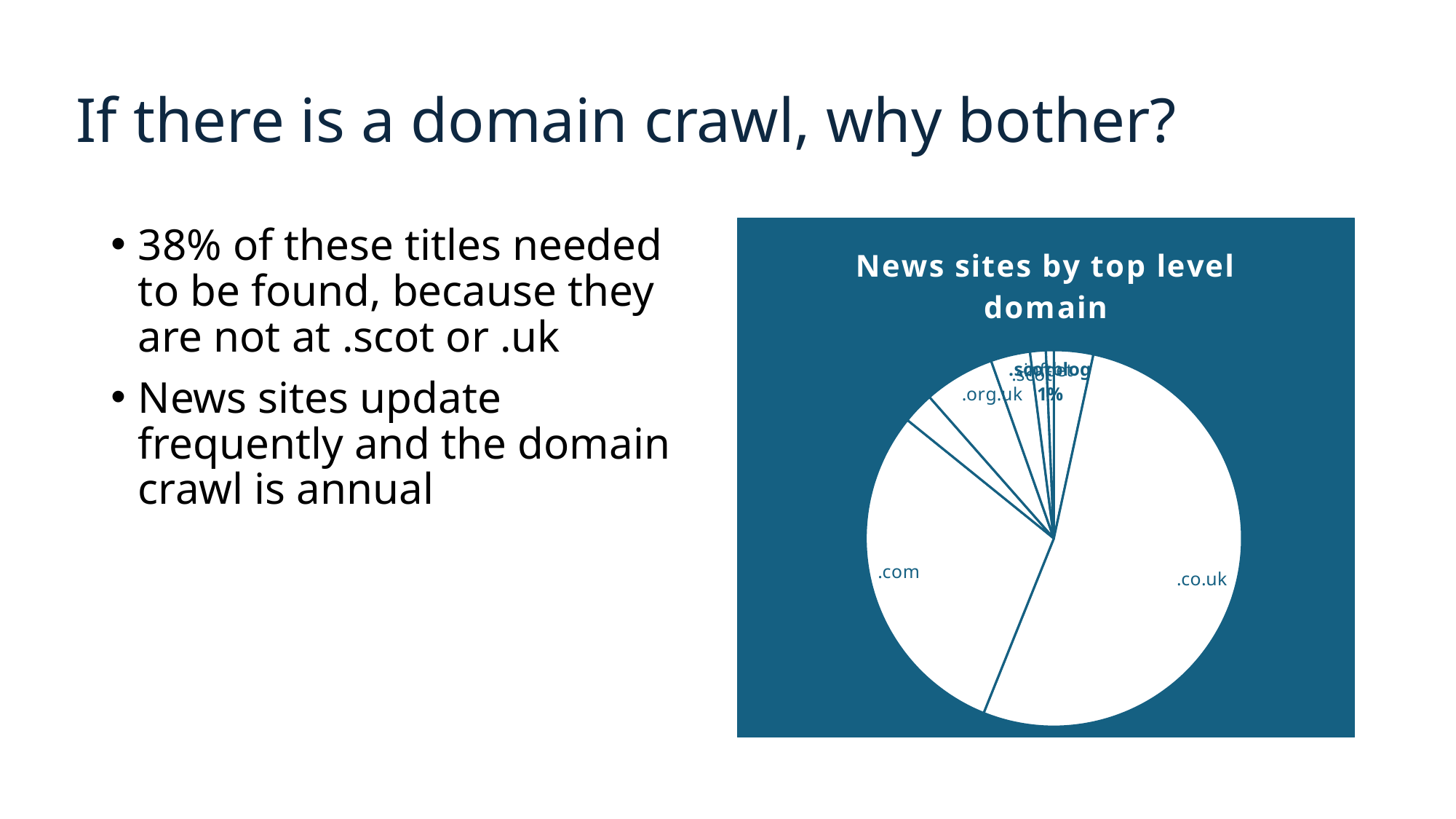
What colour is the background of the chart area? dark blue Which slice is larger, .org.uk or .co.uk? .co.uk What is the title of the chart? News sites by top level domain Is the .co.uk slice more or less than half of the pie? more Which slice is larger, .co.uk or .com? .co.uk Which top level domain has the second largest slice of the pie? .com Which top level domain has the largest slice of the pie? .co.uk What kind of chart is shown on the slide? pie chart Is the .com slice more or less than half of the pie? less Which slice is larger, .com or .org.uk? .com